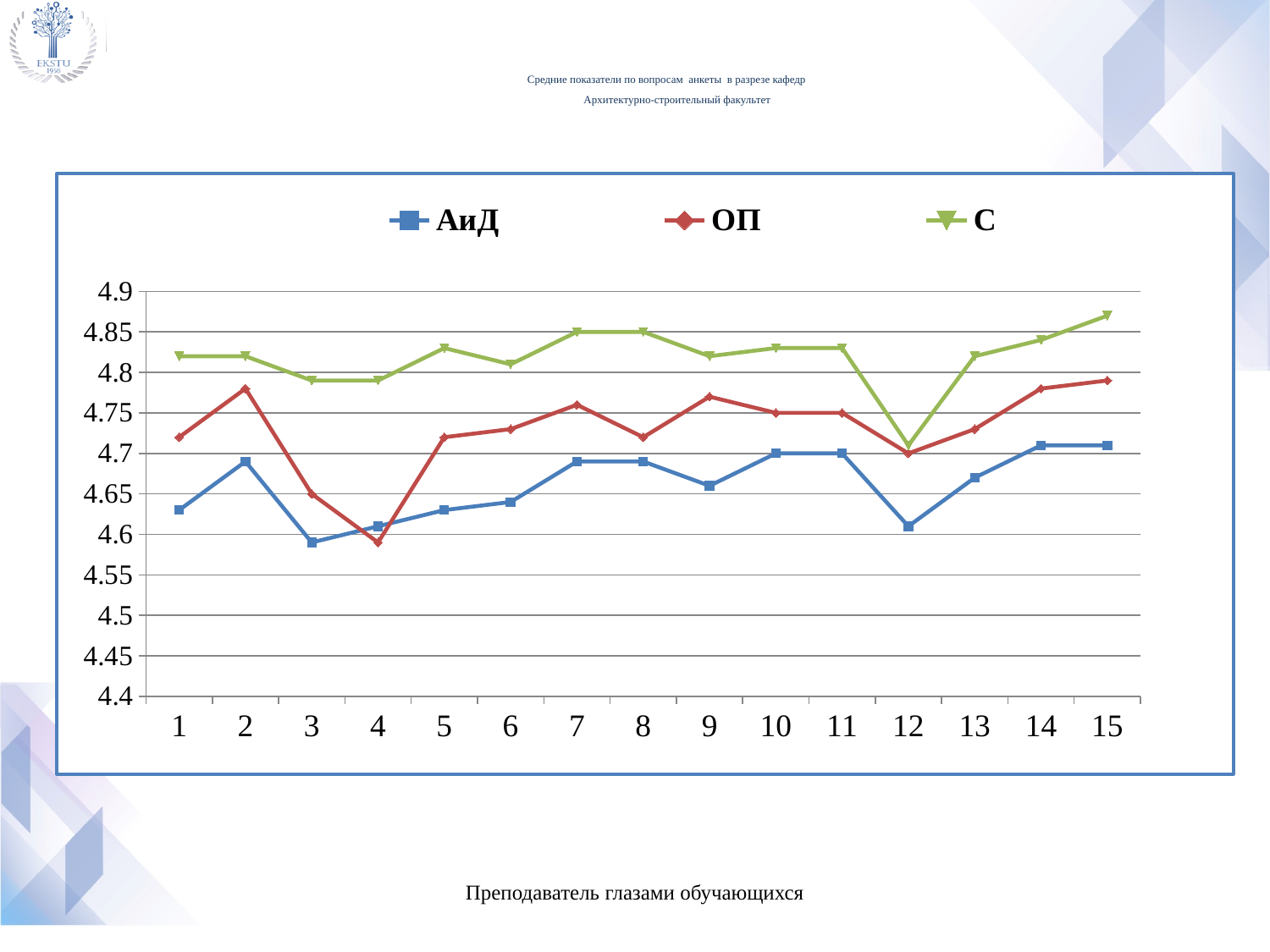
Which series has the lowest value at point 9? АиД Does the С series rise or fall from point 12 to point 15? rise At which x-axis point does the С series reach its lowest value? 12 How many series does the legend list? 3 Is the value for АиД at point 12 greater or less than 4.65? less How many points are plotted along the x axis for each series? 15 Which is larger at point 1, the value for ОП or the value for АиД? ОП At which x-axis point does the ОП series reach its lowest value? 4 Which series has the highest value at point 1? С Is the value for ОП at point 3 greater or less than 4.7? less Is the value for С at point 7 greater or less than 4.8? greater What kind of chart is shown on the slide? line chart